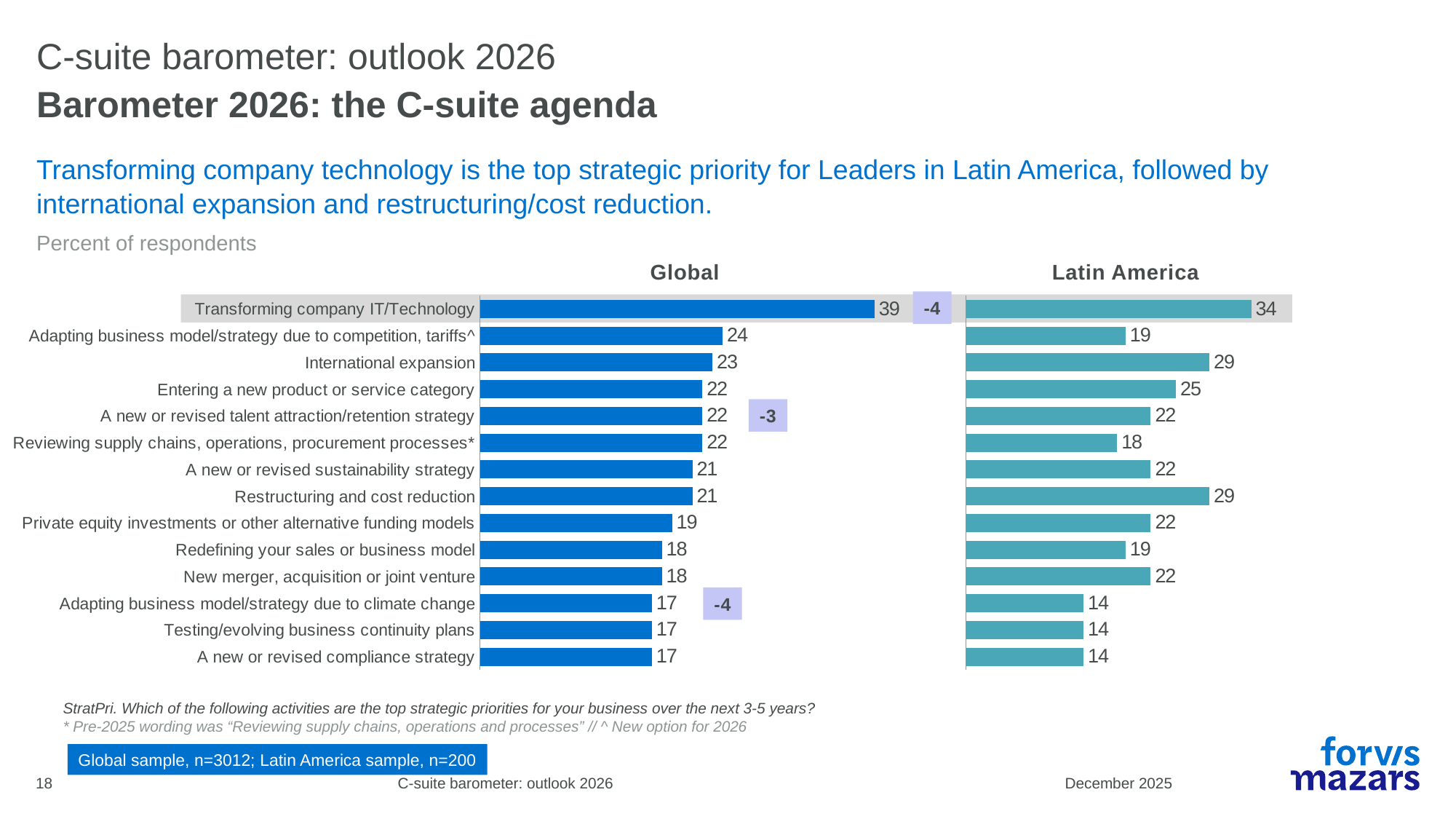
What unit are the values in the charts expressed in, according to the slide? Percent of respondents In the Global chart, which category has the highest value? Transforming company IT/Technology In the Latin America chart, what is the value for International expansion? 29 In the Global chart, what is the value for Private equity investments or other alternative funding models? 19 What is the difference between the Latin America and Global values for Entering a new product or service category? 3 How many categories are shown in the Global chart? 14 In the Latin America chart, which category has the highest value? Transforming company IT/Technology For International expansion, which is larger: the Global value or the Latin America value? Latin America What is the difference between the Global and Latin America values for Transforming company IT/Technology? 5 In the Global chart, what is the value for Transforming company IT/Technology? 39 In the Latin America chart, what is the value for Restructuring and cost reduction? 29 What kind of chart is used for the Latin America data? Bar chart